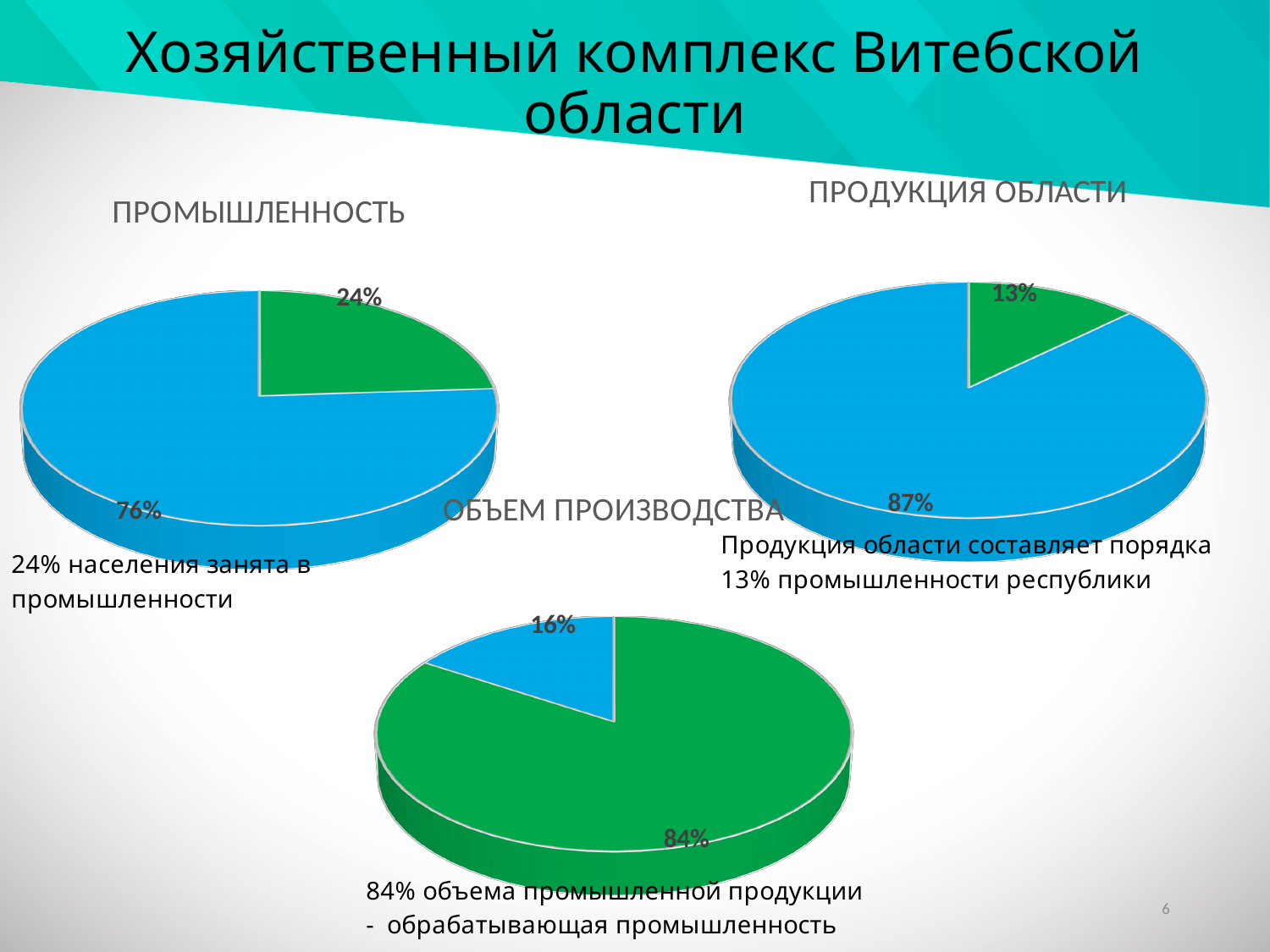
In the "ПРОДУКЦИЯ ОБЛАСТИ" chart, what value is shown on the green slice? 13% In the "ОБЪЕМ ПРОИЗВОДСТВА" chart, what value is shown on the green slice? 84% In the "ОБЪЕМ ПРОИЗВОДСТВА" chart, which slice is the largest? The green slice (84%) How many slices does the "ПРОДУКЦИЯ ОБЛАСТИ" chart have? 2 In the "ПРОДУКЦИЯ ОБЛАСТИ" chart, which slice is the smallest? The green slice (13%) How many pie charts are shown on the slide? 3 In the "ПРОМЫШЛЕННОСТЬ" chart, what value is shown on the blue slice? 76% In the "ПРОМЫШЛЕННОСТЬ" chart, what value is shown on the green slice? 24% In the "ПРОДУКЦИЯ ОБЛАСТИ" chart, what value is shown on the blue slice? 87% What type of chart is the "ПРОМЫШЛЕННОСТЬ" chart? Pie chart In the "ПРОМЫШЛЕННОСТЬ" chart, what is the difference between the blue slice and the green slice? 52% In the "ОБЪЕМ ПРОИЗВОДСТВА" chart, what value is shown on the blue slice? 16%